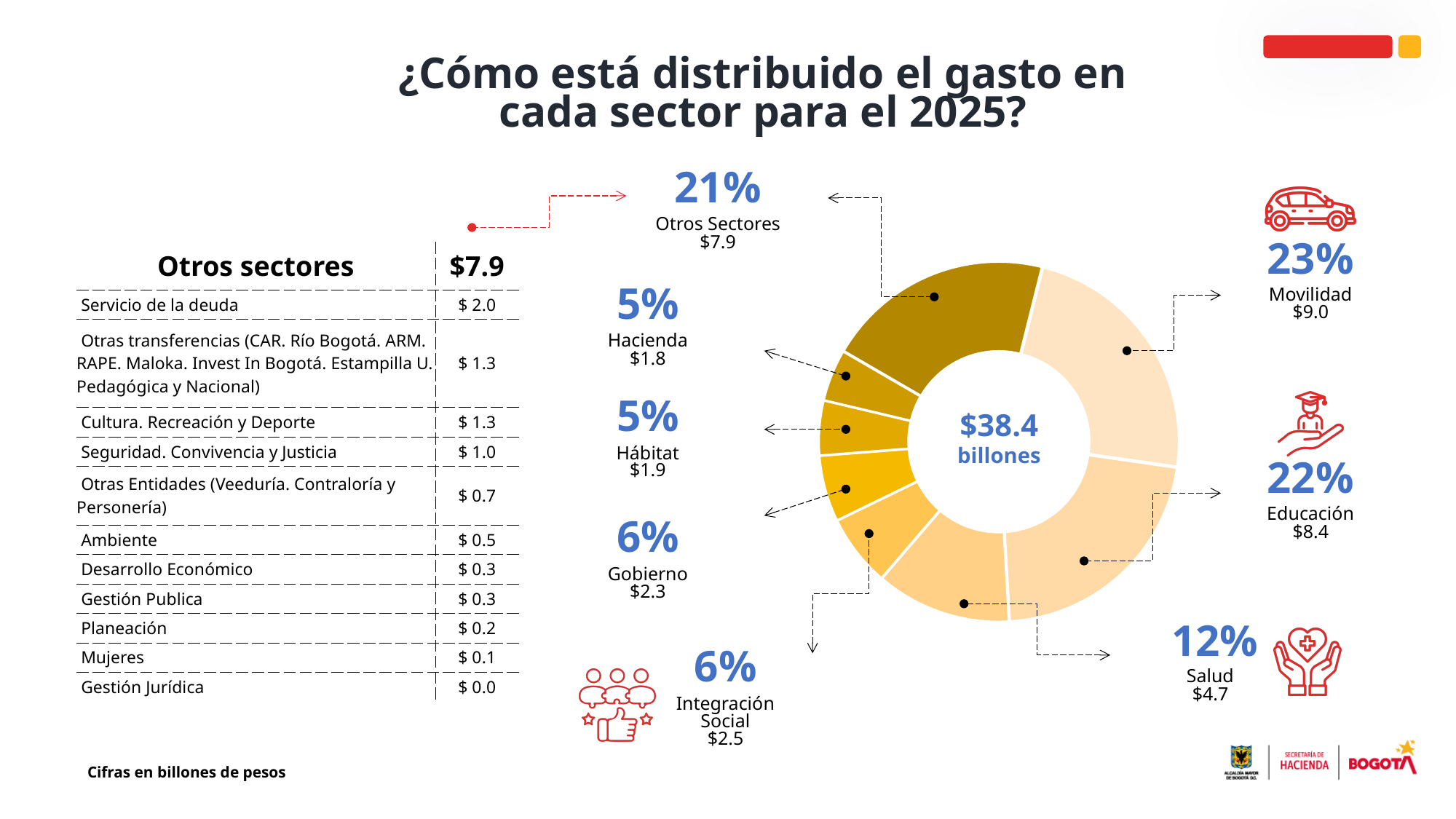
What is the total value shown in the centre of the donut chart? $38.4 billones What percentage of spending goes to Movilidad? 23% What is the difference between the values for Movilidad and Educación? $0.6 In the Otros sectores table, what is the value for Servicio de la deuda? $ 2.0 Which is larger, the value for Gobierno or the value for Hábitat? Gobierno What percentage share is shown for Otros Sectores? 21% Which sector has the smallest value shown on the donut chart? Hacienda What is the value shown for Salud? $4.7 How many sectors are labelled around the donut chart? 8 What is the value shown for Educación? $8.4 What type of chart is shown on the slide? Pie chart (donut) Which sector has the largest share of the donut chart? Movilidad